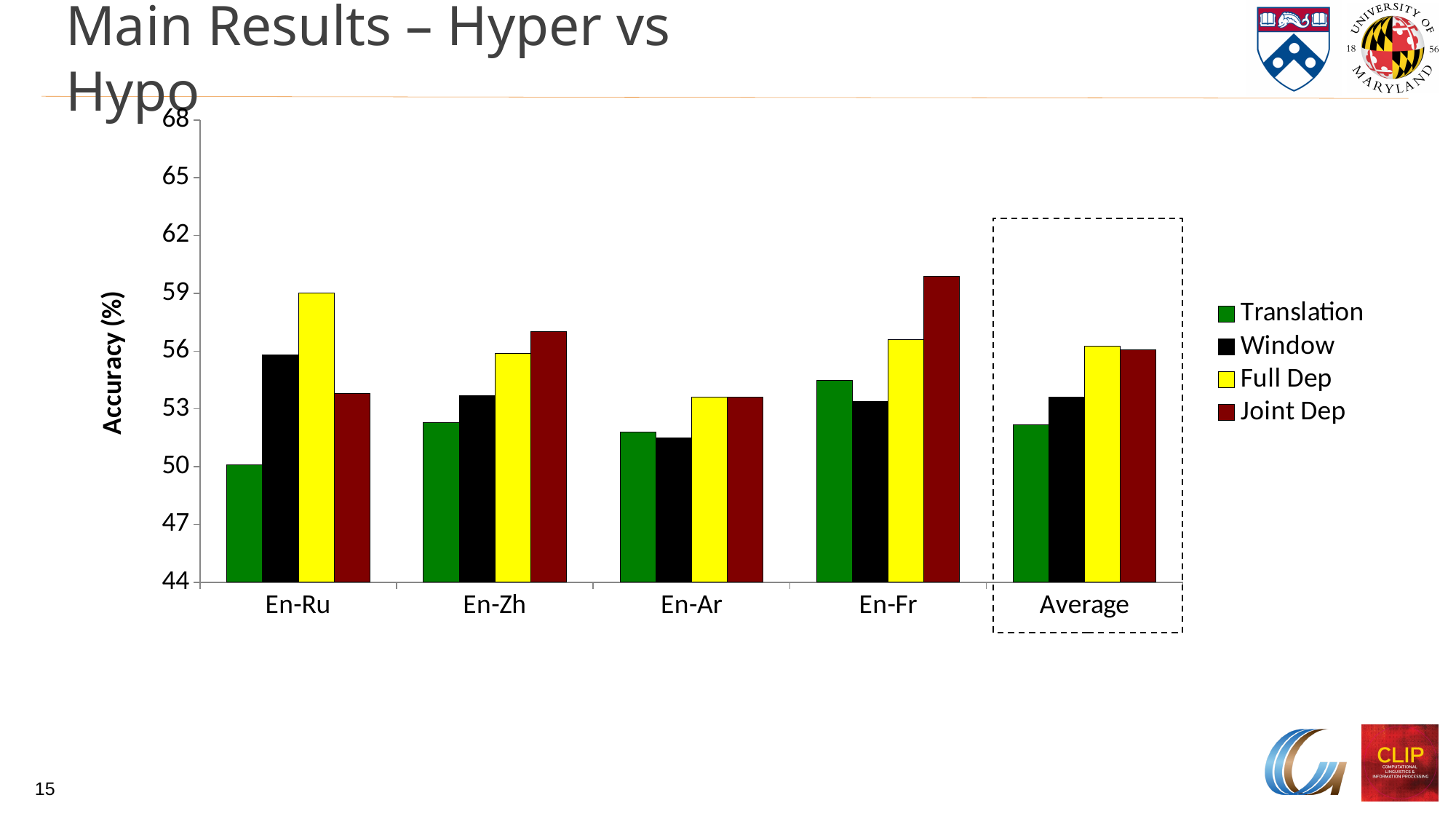
Is the Joint Dep value for En-Zh greater or less than 56? greater How many categories are shown on the x axis of the chart? 5 For En-Ru, which is larger: the Window value or the Joint Dep value? Window Which category has the lowest Translation value? En-Ru How many series does the legend list? 4 What kind of chart is shown on the slide? bar chart For En-Fr, which is larger: the Translation value or the Window value? Translation Is the Translation value for En-Ru greater or less than 53? less What is the label of the y axis? Accuracy (%) Which category has the highest Joint Dep value? En-Fr Is the Joint Dep value for En-Fr greater or less than 59? greater For En-Ru, which series has the highest bar? Full Dep